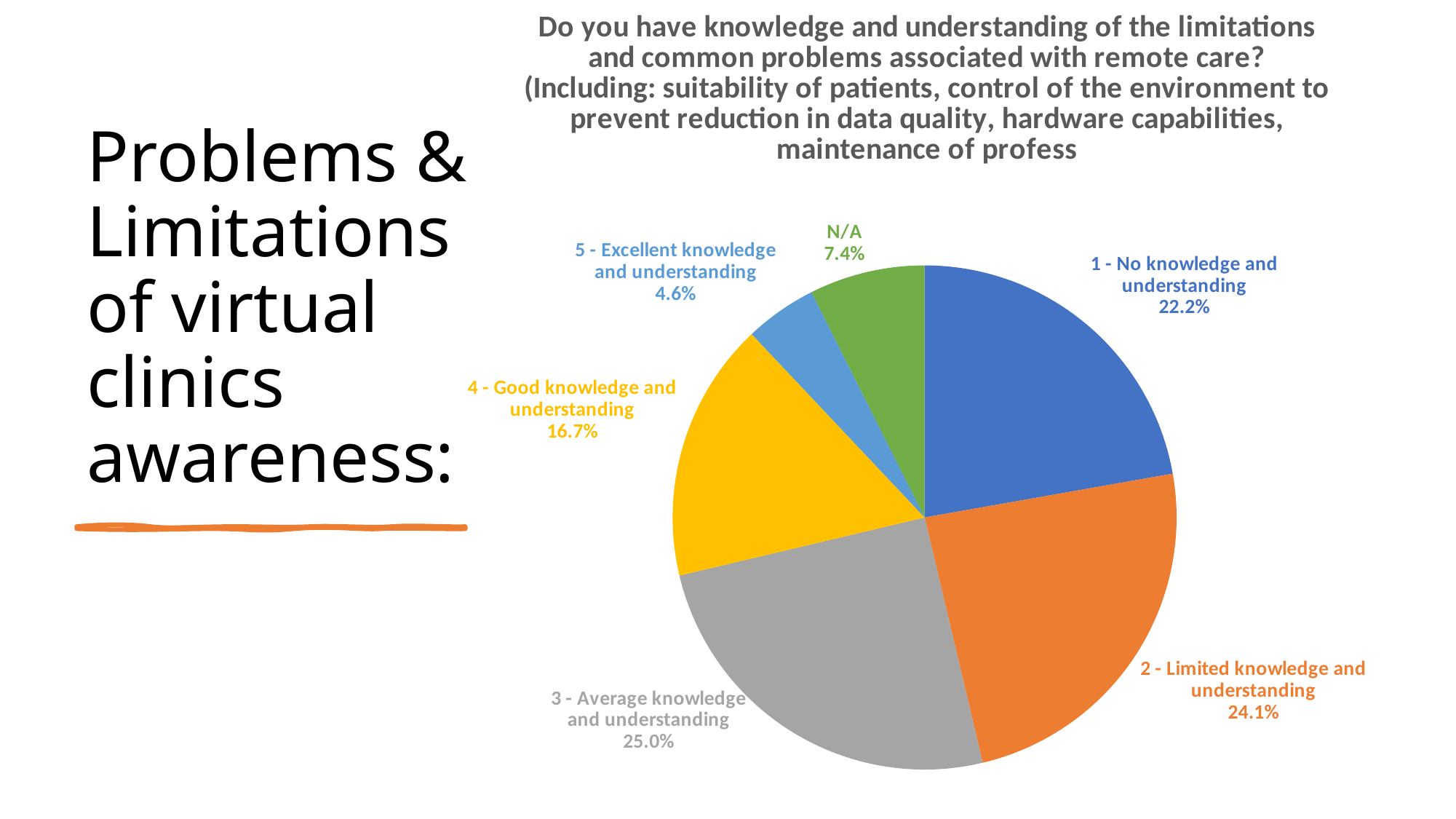
What percentage of respondents reported '3 - Average knowledge and understanding'? 25.0% What percentage of respondents reported '1 - No knowledge and understanding'? 22.2% What percentage of respondents answered N/A? 7.4% Which category has the smallest share of the pie? 5 - Excellent knowledge and understanding What percentage of respondents reported '5 - Excellent knowledge and understanding'? 4.6% Which category has the largest share of the pie? 3 - Average knowledge and understanding What colour is the slice for '4 - Good knowledge and understanding'? yellow What is the combined share of '1 - No knowledge and understanding' and '2 - Limited knowledge and understanding'? 46.3% What kind of chart is shown on the slide? pie chart How many slices does the pie chart have? 6 What is the difference in percentage points between '2 - Limited knowledge and understanding' and '4 - Good knowledge and understanding'? 7.4 Which is larger: the share for '1 - No knowledge and understanding' or the share for '4 - Good knowledge and understanding'? 1 - No knowledge and understanding